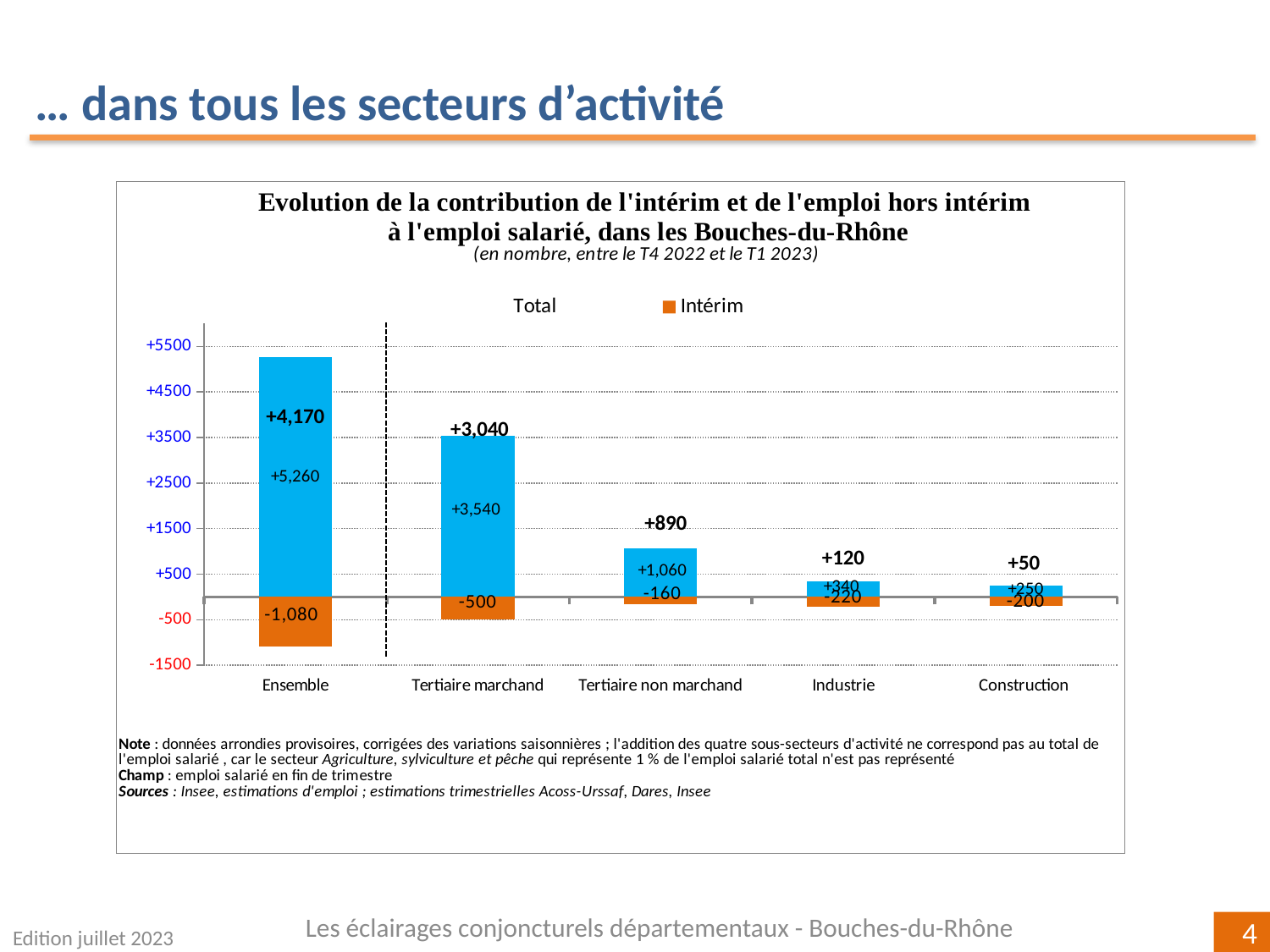
What is the total value shown above the bar for Ensemble? +4,170 Which category has the highest total value? Ensemble What is the total value shown for Construction? +50 What kind of chart is this? Bar chart Which has a larger blue segment value, Industrie or Construction? Industrie What is the value of the blue segment for Tertiaire non marchand? +1,060 Which category has the lowest total value? Construction What is the Intérim value for Ensemble? -1,080 What colour represents Intérim in the legend? Orange What is the difference between the total for Tertiaire marchand and the total for Tertiaire non marchand? 2,150 What is the Intérim value for Tertiaire marchand? -500 How many categories are shown on the x axis? 5